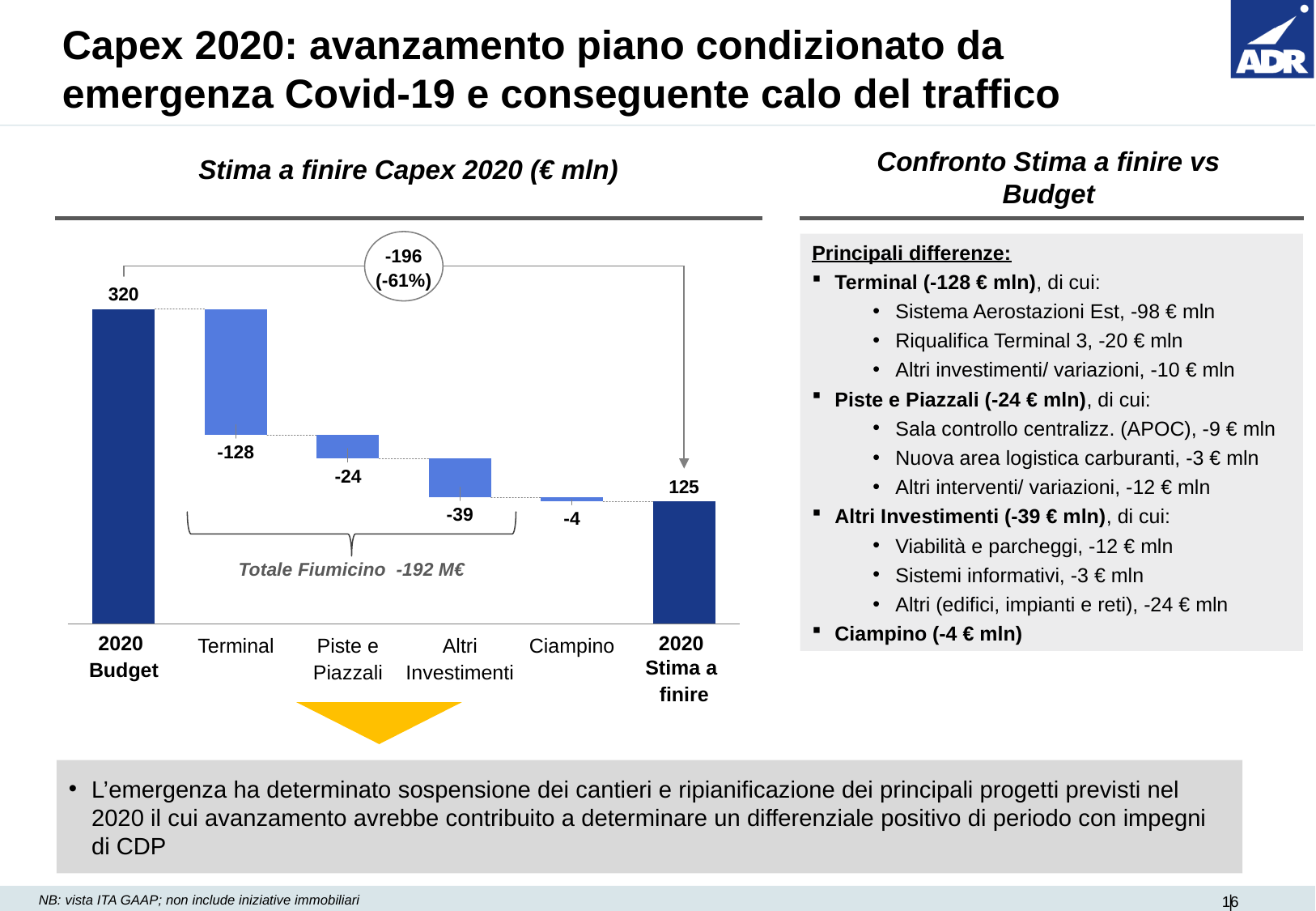
What is the value of the 2020 Stima a finire bar in the chart? 125 What percentage change from Budget to Stima a finire is shown in the circle above the chart? -61% What is the value shown for Altri Investimenti in the chart? -39 Which category in the chart has the smallest negative adjustment? Ciampino What is the value shown for Terminal in the chart? -128 What is the difference between the 2020 Budget and the 2020 Stima a finire values in the chart? -196 Which category in the chart has the largest negative adjustment? Terminal What is the value of the 2020 Budget bar in the chart 'Stima a finire Capex 2020 (€ mln)'? 320 What is the value shown for Piste e Piazzali in the chart? -24 What is the value shown for Ciampino in the chart? -4 Which is larger in absolute terms, the Altri Investimenti adjustment or the Piste e Piazzali adjustment? Altri Investimenti How many categories are shown on the x axis of the chart? 6